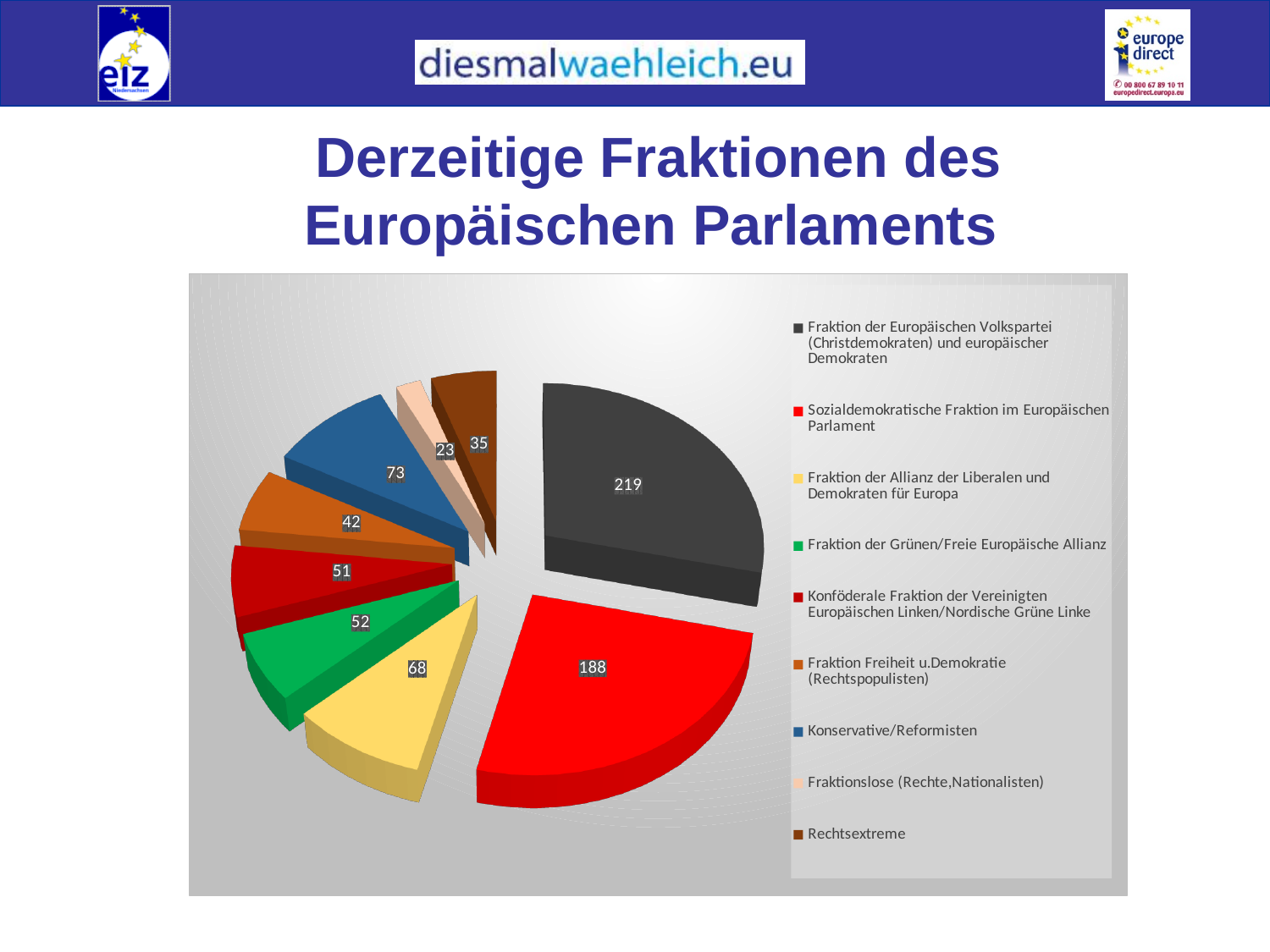
What is the difference between the value for the Fraktion der Europäischen Volkspartei and the Sozialdemokratische Fraktion? 31 What kind of chart is shown on the slide? pie chart What is the value for the Sozialdemokratische Fraktion im Europäischen Parlament? 188 What is the value for the Fraktion der Grünen/Freie Europäische Allianz? 52 Which group has the smallest slice of the pie? Fraktionslose (Rechte,Nationalisten) What is the value for Fraktionslose (Rechte,Nationalisten)? 23 How many slices does the pie chart have? 9 Which is larger: the value for Konservative/Reformisten or the value for Fraktion der Allianz der Liberalen und Demokraten für Europa? Konservative/Reformisten What is the value for Konservative/Reformisten? 73 What colour is the slice for Rechtsextreme? brown What is the total of all the values shown in the pie chart? 751 Which group has the largest slice of the pie? Fraktion der Europäischen Volkspartei (Christdemokraten) und europäischer Demokraten